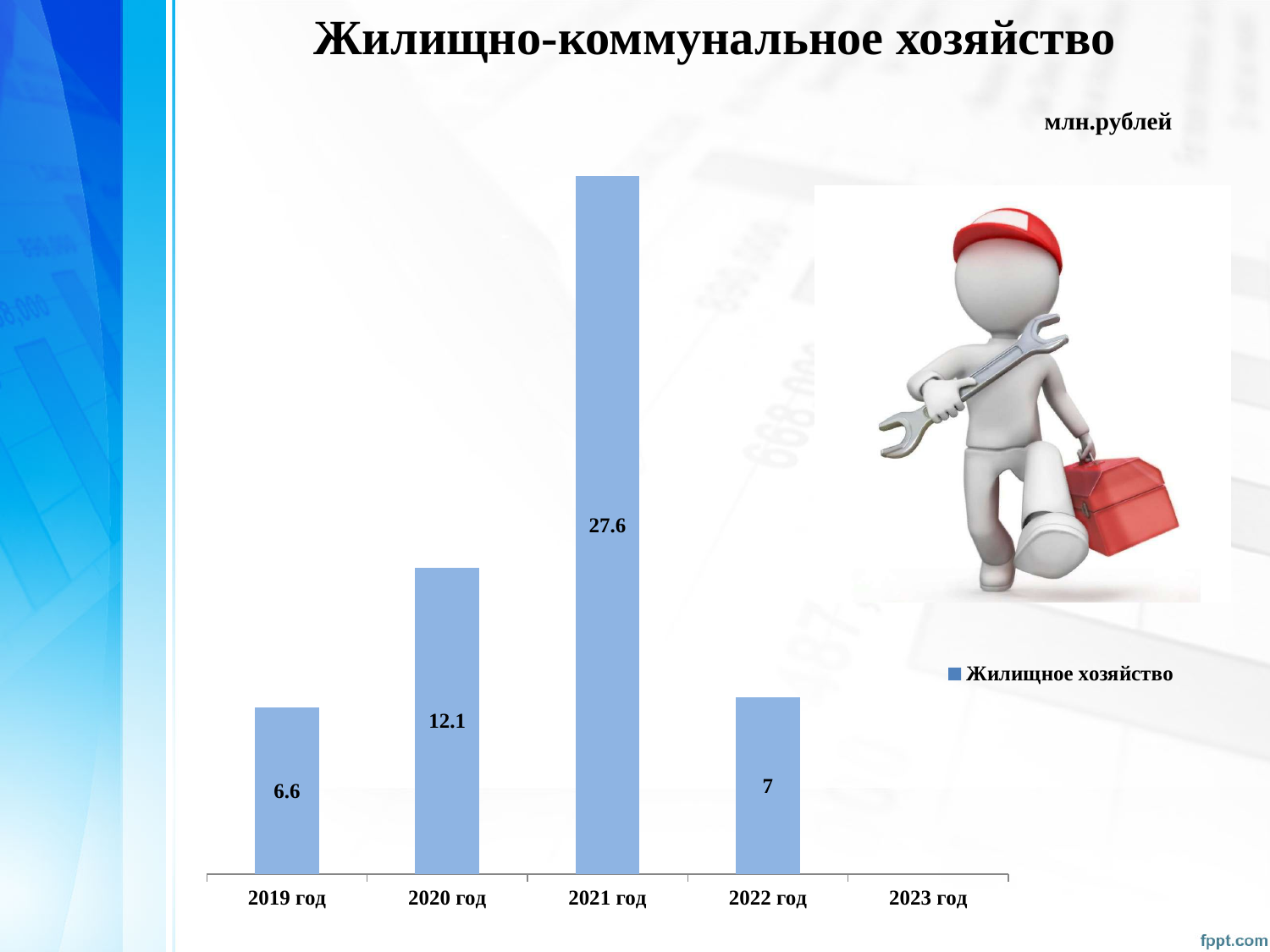
What is the difference between the values for 2020 год and 2019 год? 5.5 What is the value for 2022 год? 7 What is the difference between the values for 2021 год and 2020 год? 15.5 Which year with a plotted bar has the lowest value? 2019 год How many year categories are shown on the x axis? 5 Which year has the highest value? 2021 год What is the value for 2020 год? 12.1 What is the value for 2019 год? 6.6 What series name does the legend show? Жилищное хозяйство What kind of chart is shown on the slide? Bar chart What is the value for 2021 год? 27.6 Which is larger, the value for 2022 год or the value for 2019 год? 2022 год